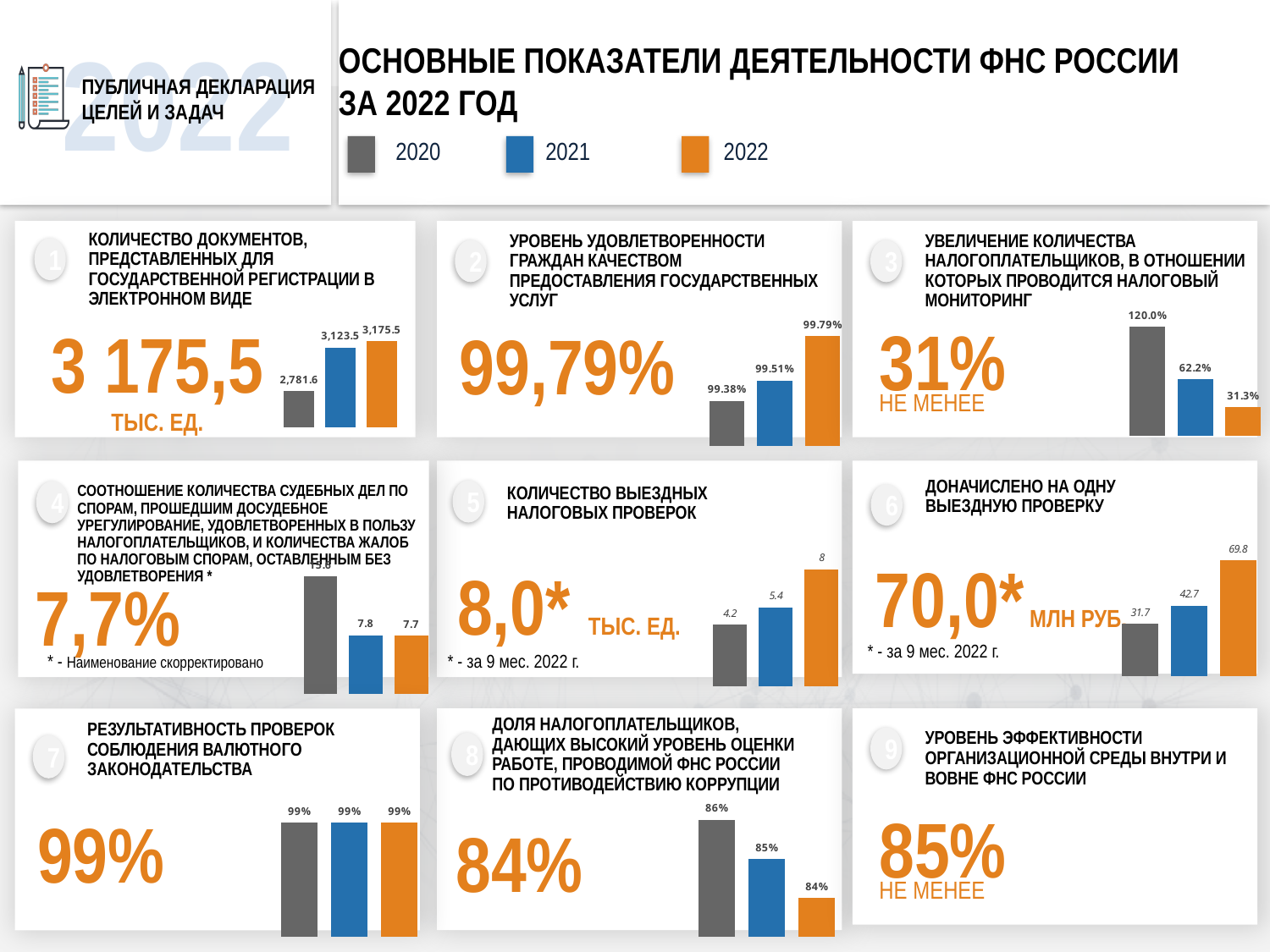
In the chart for indicator 5 (number of field tax audits), what is the value for 2022? 8 According to the legend at the top of the slide, which year is shown in orange? 2022 In the chart for indicator 1 (number of documents submitted for state registration in electronic form), what is the value for 2020? 2,781.6 In the chart for indicator 2 (level of citizen satisfaction with the quality of public services), what is the value for 2021? 99.51% In the chart for indicator 8 (share of taxpayers rating the FTS anti-corruption work highly), which is larger: the 2020 value or the 2022 value? 2020 In the chart for indicator 3 (increase in the number of taxpayers under tax monitoring), which year has the highest value? 2020 In the chart for indicator 5 (number of field tax audits), do the values rise or fall from 2020 to 2022? rise In the chart for indicator 6 (additional charges per field audit), which year has the lowest value? 2020 In the chart for indicator 1 (number of documents submitted for state registration in electronic form), what is the value for 2022? 3,175.5 In the chart for indicator 6 (additional charges per field audit), what is the difference between the 2022 and 2020 values? 38.1 In the chart for indicator 7 (effectiveness of currency legislation compliance checks), how many bars are shown? 3 In the chart for indicator 3 (increase in the number of taxpayers under tax monitoring), what is the difference between the 2021 and 2022 values? 30.9%